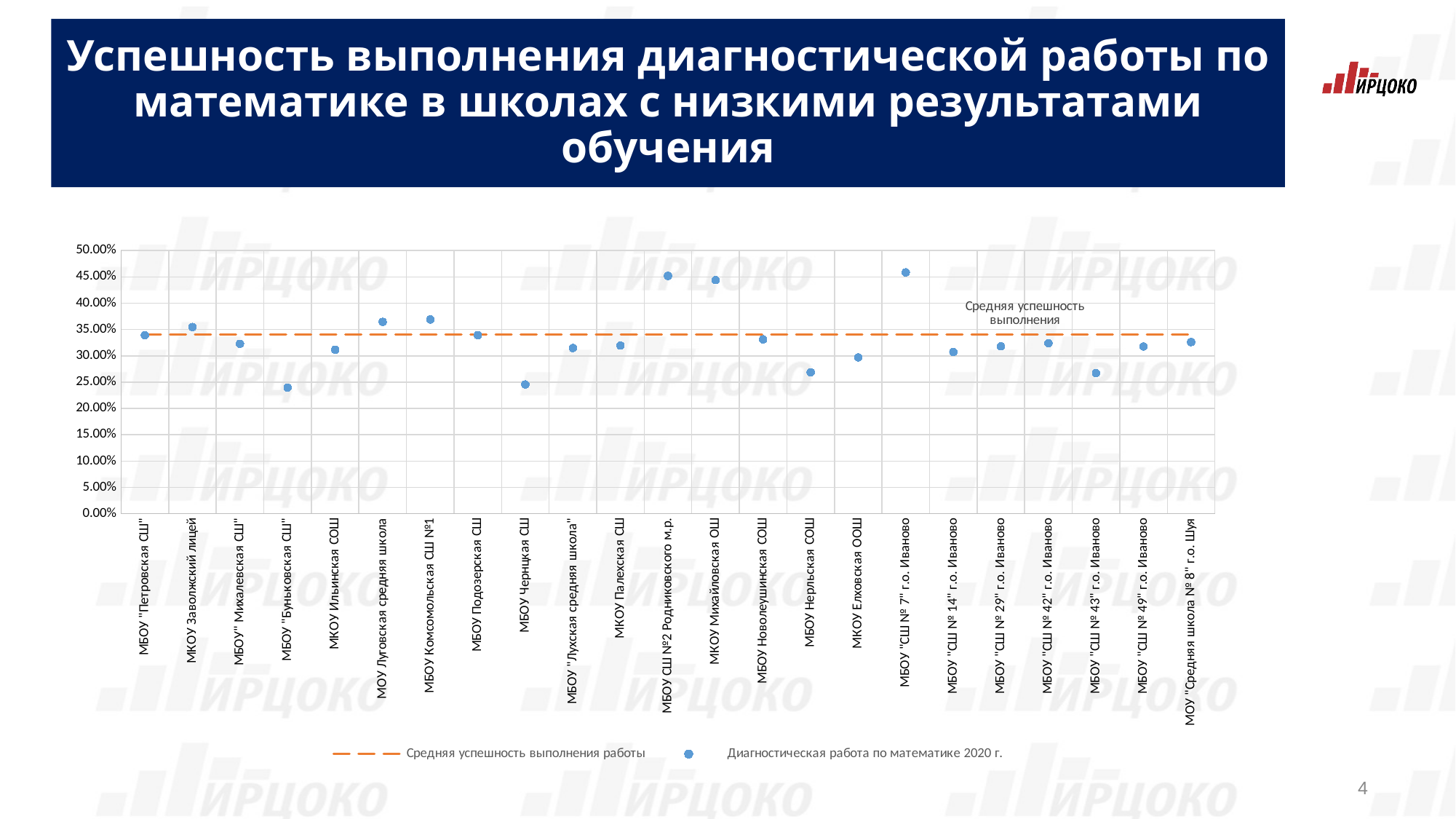
What is the name of the series shown as blue dots in the legend? Диагностическая работа по математике 2020 г. What kind of chart is shown on the slide? Scatter chart Is the value for МБОУ "Буньковская СШ" greater or less than 30.00%? less Is the value for МКОУ Михайловская ОШ greater or less than 40.00%? greater How many series does the chart legend list? 2 Is the value for МБОУ "СШ № 43" г.о. Иваново greater or less than 30.00%? less What does the dashed orange line in the chart represent, according to the legend? Средняя успешность выполнения работы Which has the higher value: МОУ Луговская средняя школа or МБОУ "Буньковская СШ"? МОУ Луговская средняя школа How many schools are plotted along the x axis of the chart? 23 Which has the higher value: МБОУ СШ №2 Родниковского м.р. or МБОУ Нерльская СОШ? МБОУ СШ №2 Родниковского м.р.